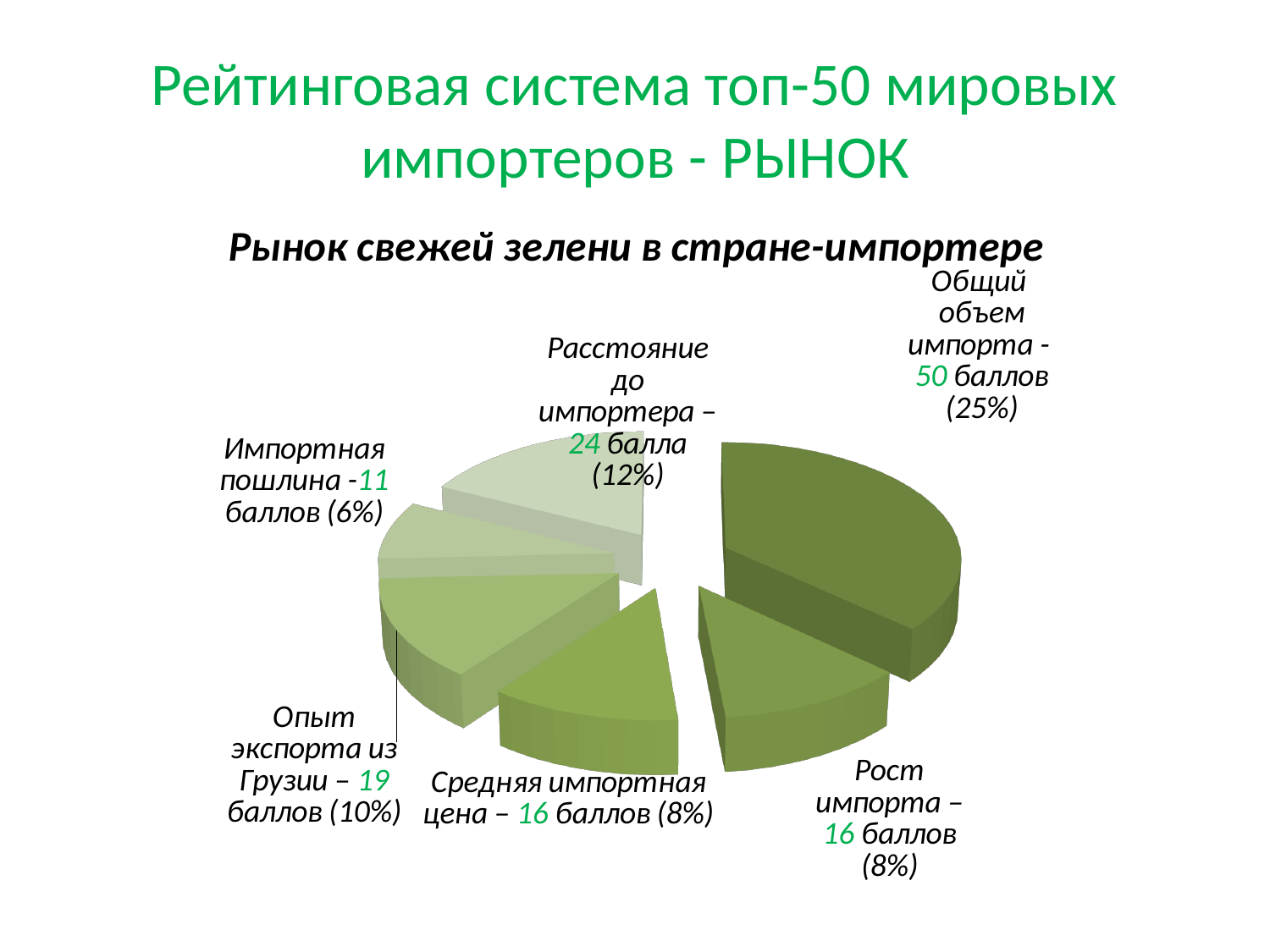
Which category has the largest slice of the pie? Общий объем импорта Which has more points: "Опыт экспорта из Грузии" or "Средняя импортная цена"? Опыт экспорта из Грузии What kind of chart is shown on the slide? Pie chart What percentage share is shown for "Общий объем импорта"? 25% How many points are assigned to "Расстояние до импортера"? 24 балла What is the difference in points between "Общий объем импорта" and "Расстояние до импортера"? 26 What percentage share is shown for "Опыт экспорта из Грузии"? 10% How many slices does the pie chart have? 6 Which category has the smallest slice of the pie? Импортная пошлина What is the chart's title? Рынок свежей зелени в стране-импортере How many points (баллов) are assigned to "Общий объем импорта"? 50 баллов How many points are assigned to "Импортная пошлина"? 11 баллов